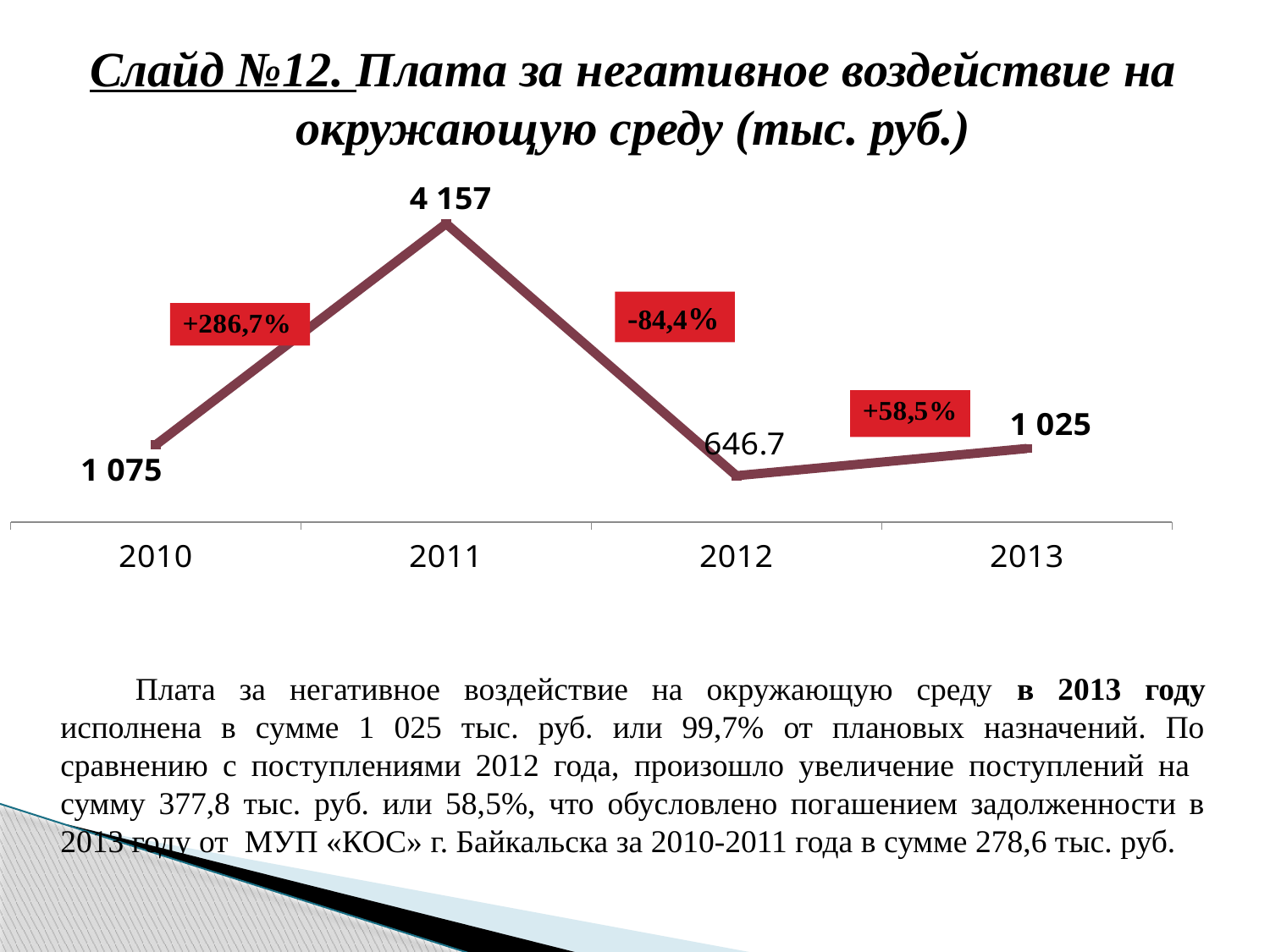
Which is larger, the value for 2010 or the value for 2013? 2010 What type of chart is shown on the slide? Line chart What is the difference between the values for 2011 and 2010? 3 082 How many years are plotted on the chart? 4 What percentage change is labelled between 2012 and 2013? +58,5% Which year has the highest value? 2011 Does the value rise or fall from 2011 to 2012? Fall Which year has the lowest value? 2012 What is the value for 2013? 1 025 What is the value for 2010? 1 075 What is the value for 2012? 646.7 What is the value for 2011? 4 157